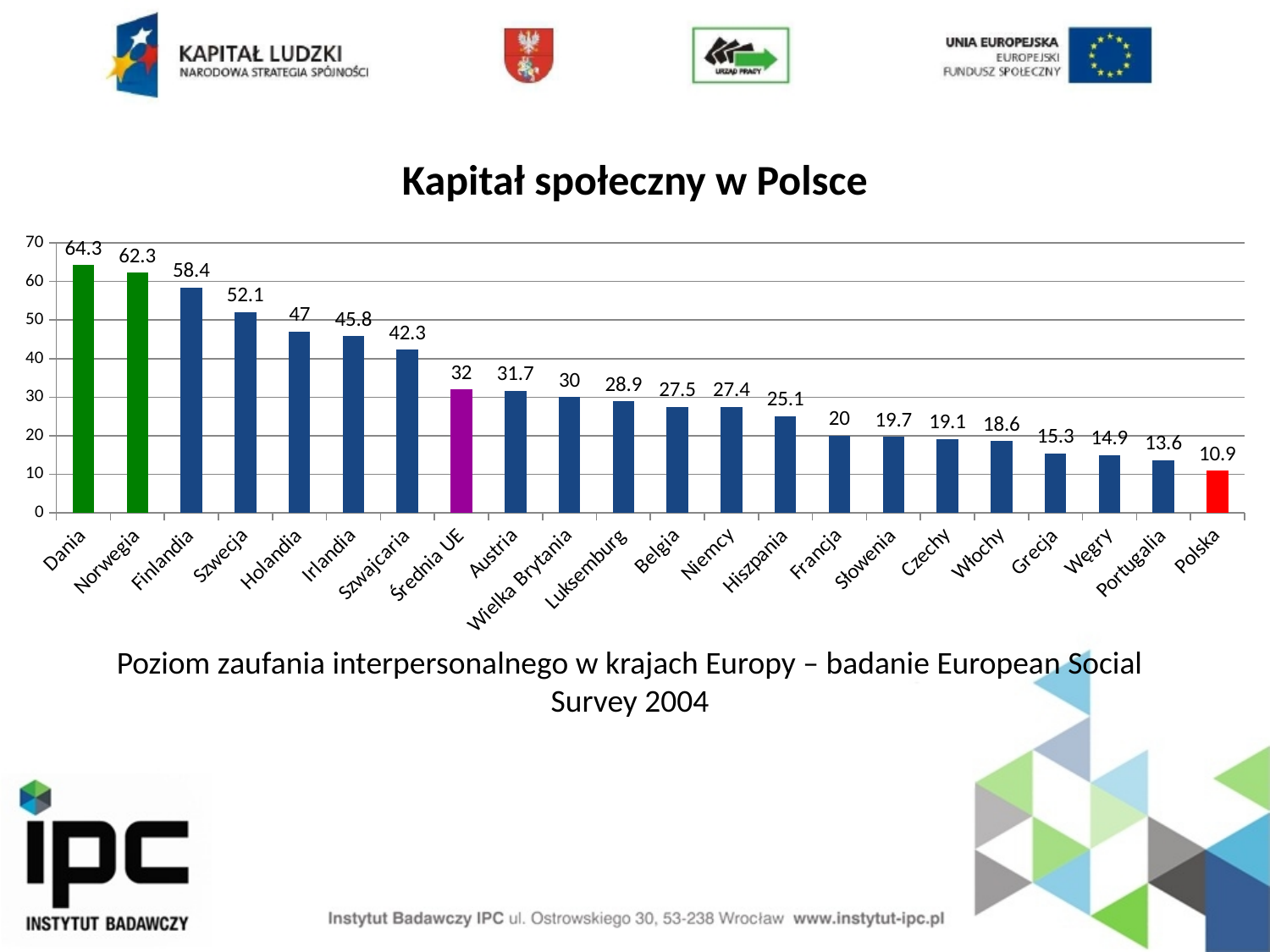
What is the value for Dania? 64.3 What kind of chart is shown on the slide? bar chart What is the value for Polska? 10.9 What is the difference between the values for Finlandia and Szwecja? 6.3 Which country has the lowest value? Polska What is the difference between the values for Dania and Polska? 53.4 Which country has the highest value? Dania What is the value for Średnia UE? 32 How many bars are shown in the chart? 22 Which is larger, the value for Austria or the value for Luksemburg? Austria Do the values rise or fall from left to right along the x axis? fall What is the value for Niemcy? 27.4